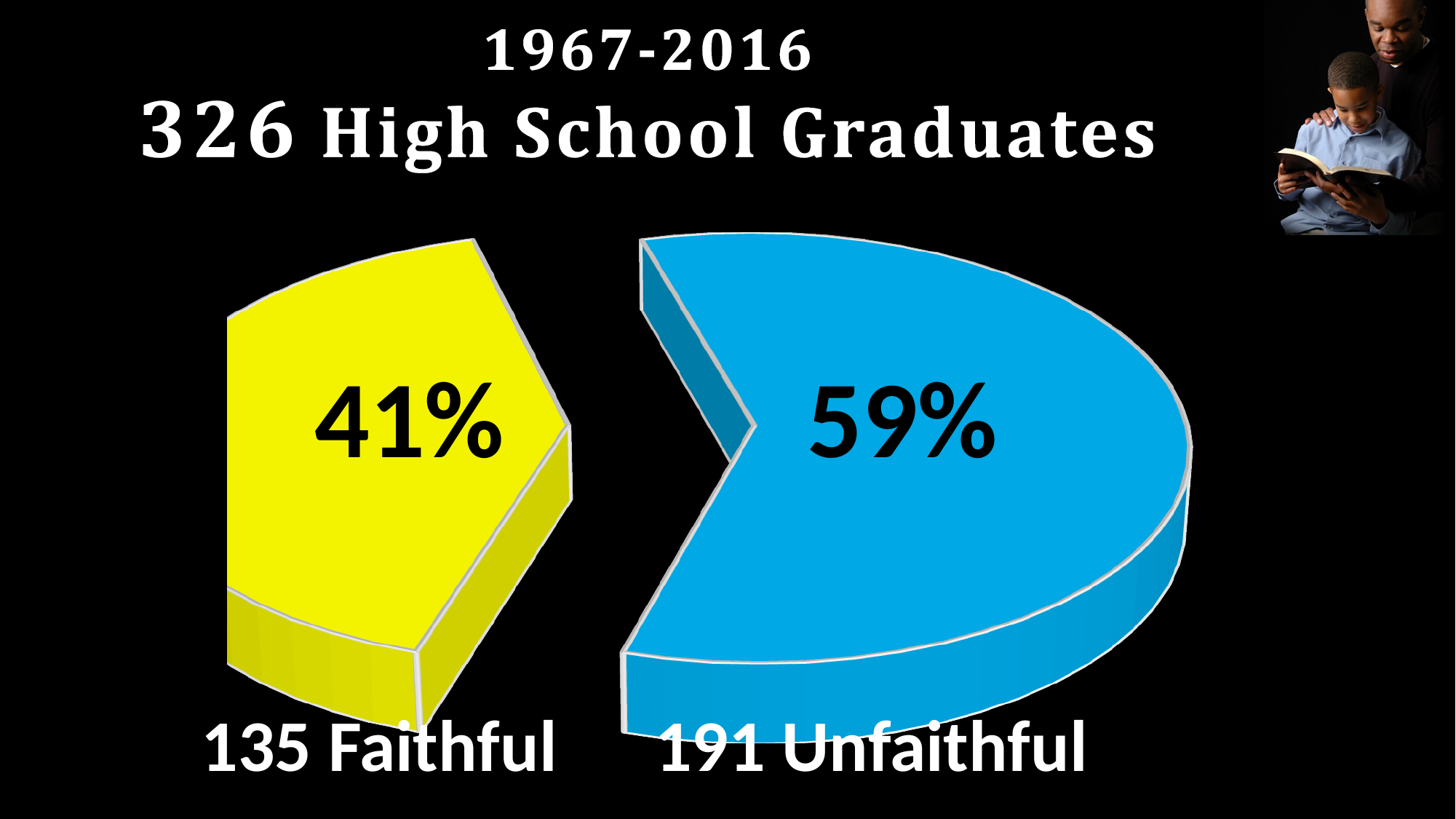
Which slice of the pie is the smallest? Faithful How many slices does the pie chart have? 2 Which is larger, the Faithful count or the Unfaithful count? Unfaithful How many graduates are labelled Faithful? 135 Which slice of the pie is the largest? Unfaithful What colour is the Faithful slice? yellow How many graduates are labelled Unfaithful? 191 What is the difference in percentage points between the Unfaithful and Faithful slices? 18 What percentage of the pie is labelled Faithful? 41% What kind of chart is shown on the slide? pie chart What is the difference between the Unfaithful count and the Faithful count? 56 What percentage of the pie is labelled Unfaithful? 59%